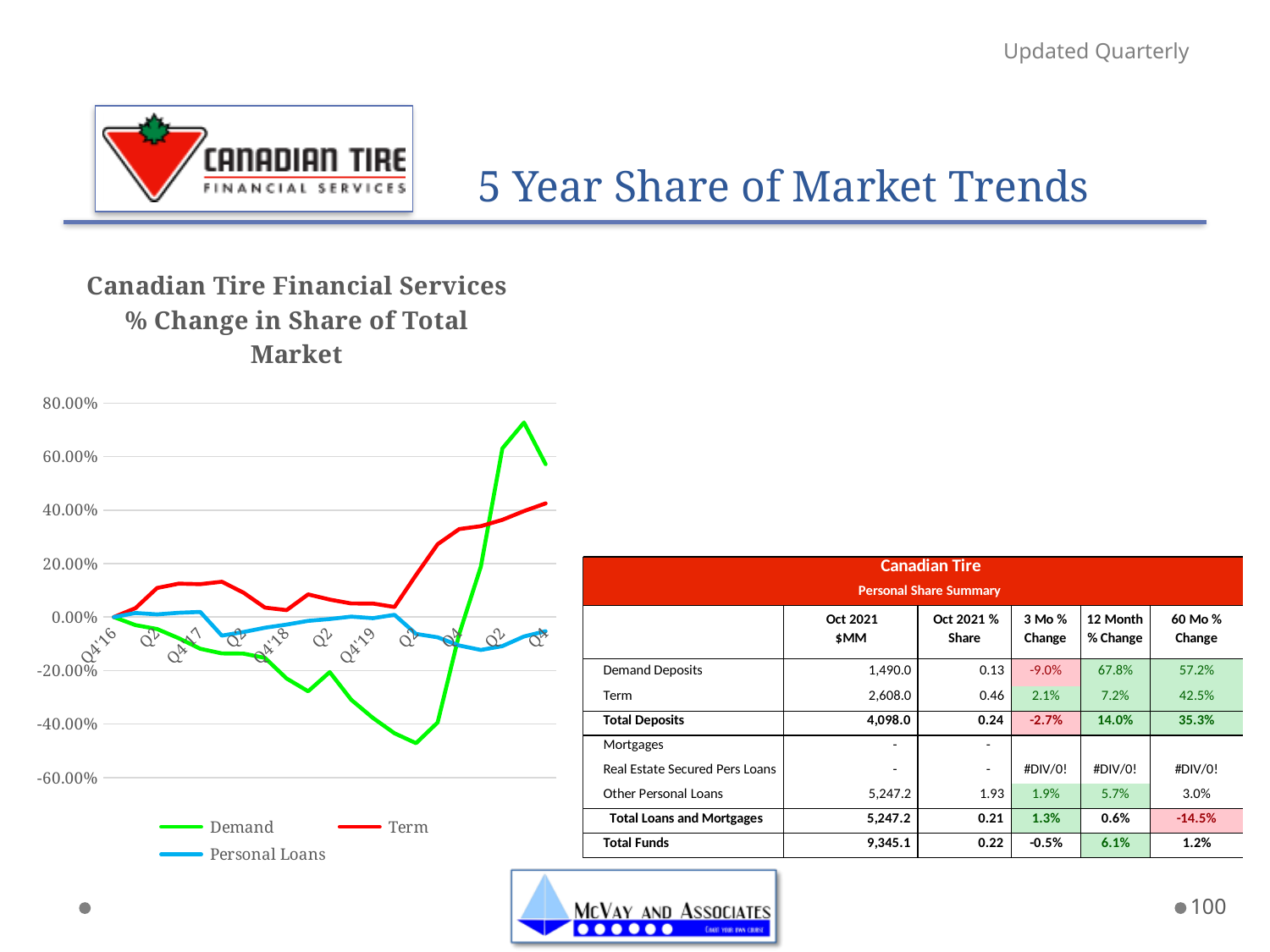
What kind of chart is shown on the slide? line chart Which series reaches the highest value on the chart? Demand What colour is the Term line in the chart? red Is the value of the Term line at the final point greater or less than 20.00%? greater How many series does the chart legend list? 3 What are the three series named in the chart legend? Demand, Term, Personal Loans Which series reaches the lowest value on the chart? Demand Is the lowest value of the Demand line greater or less than -40.00%? less Does the Term line rise or fall overall from the first point to the last point on the x axis? rise At the final point on the x axis, which series has the lowest value? Personal Loans At the final point on the x axis, which is higher, Demand or Term? Demand Is the peak value of the Demand line greater or less than 60.00%? greater